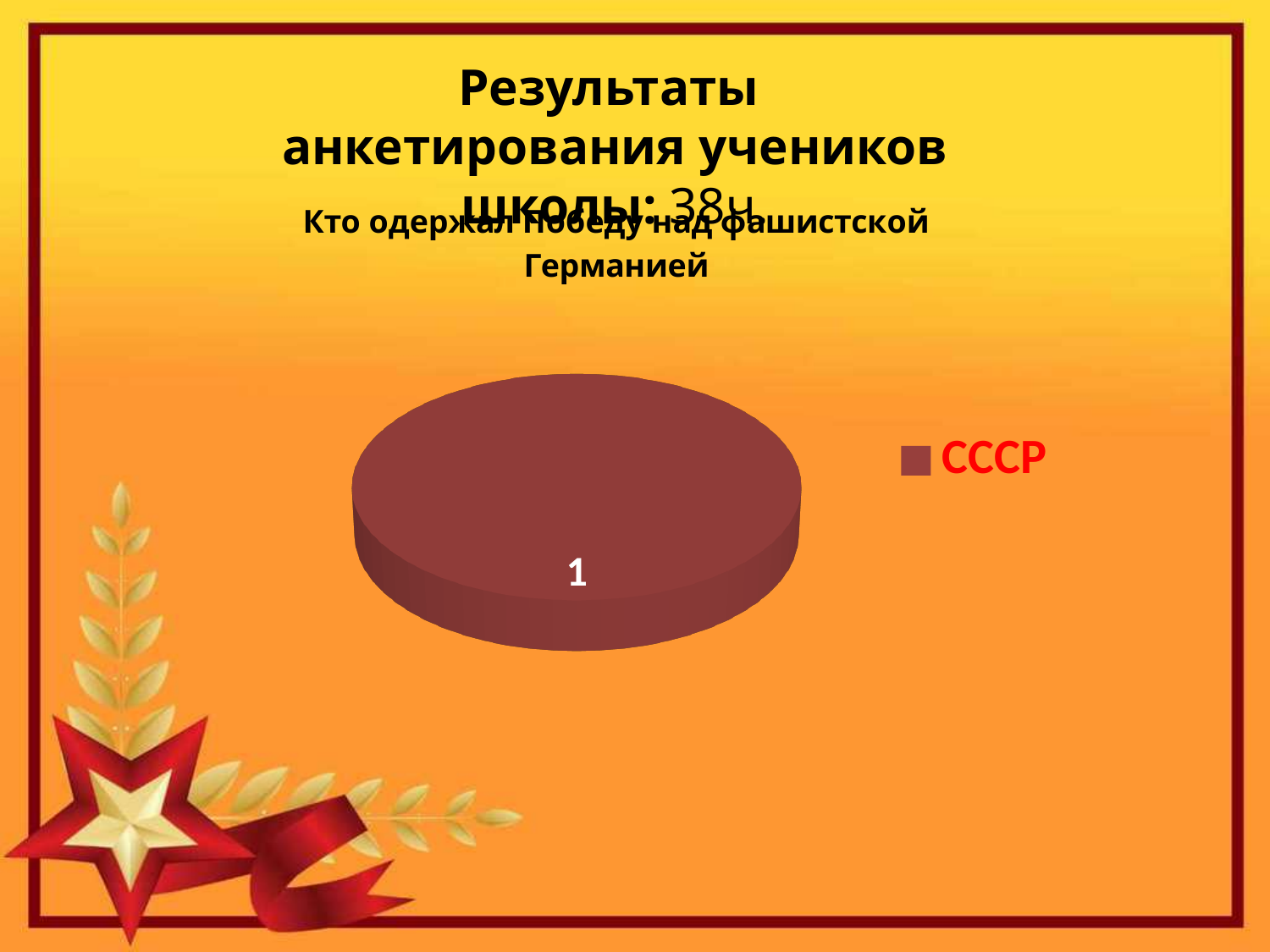
What is the name of the only category in the chart legend? СССР What kind of chart is shown on the slide? pie chart What value is shown for СССР in the pie chart? 1 What colour is the СССР slice in the pie chart? dark red What is the data label shown on the pie slice? 1 How many slices does the pie chart have? 1 What share of the pie does the СССР slice take up? 100% How many entries does the chart legend list? 1